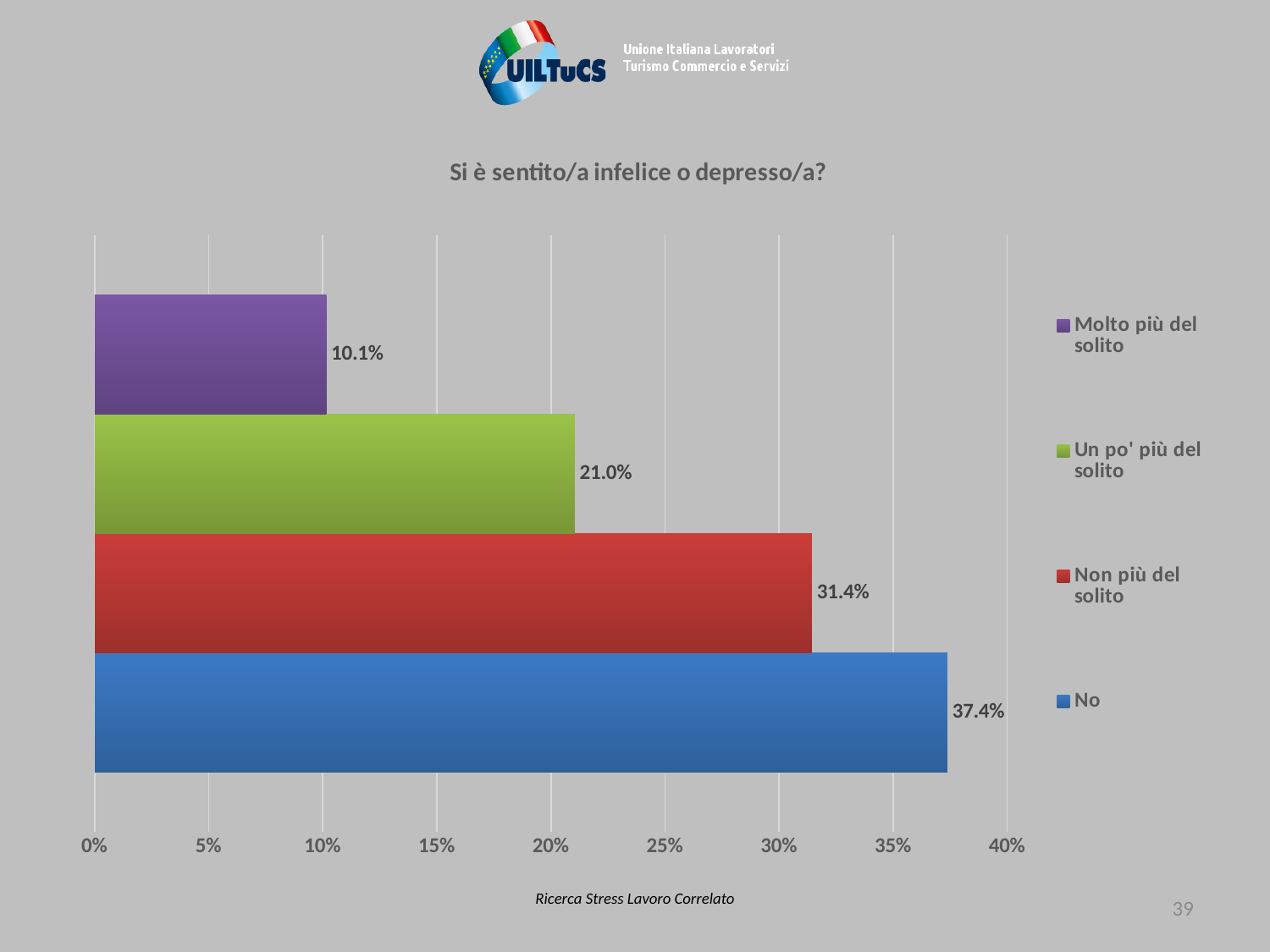
Which is larger, the value for "Un po' più del solito" or the value for "Molto più del solito"? Un po' più del solito What is the value for "Un po' più del solito"? 21.0% What kind of chart is shown on the slide? bar chart Which category has the highest value? No What is the value for "No"? 37.4% Is the value for "Non più del solito" greater or less than 30%? greater What is the value for "Non più del solito"? 31.4% How many categories are shown in the chart? 4 What is the value for "Molto più del solito"? 10.1% Which category has the lowest value? Molto più del solito What is the difference between the values for "No" and "Non più del solito"? 6.0% What is the title of the chart? Si è sentito/a infelice o depresso/a?